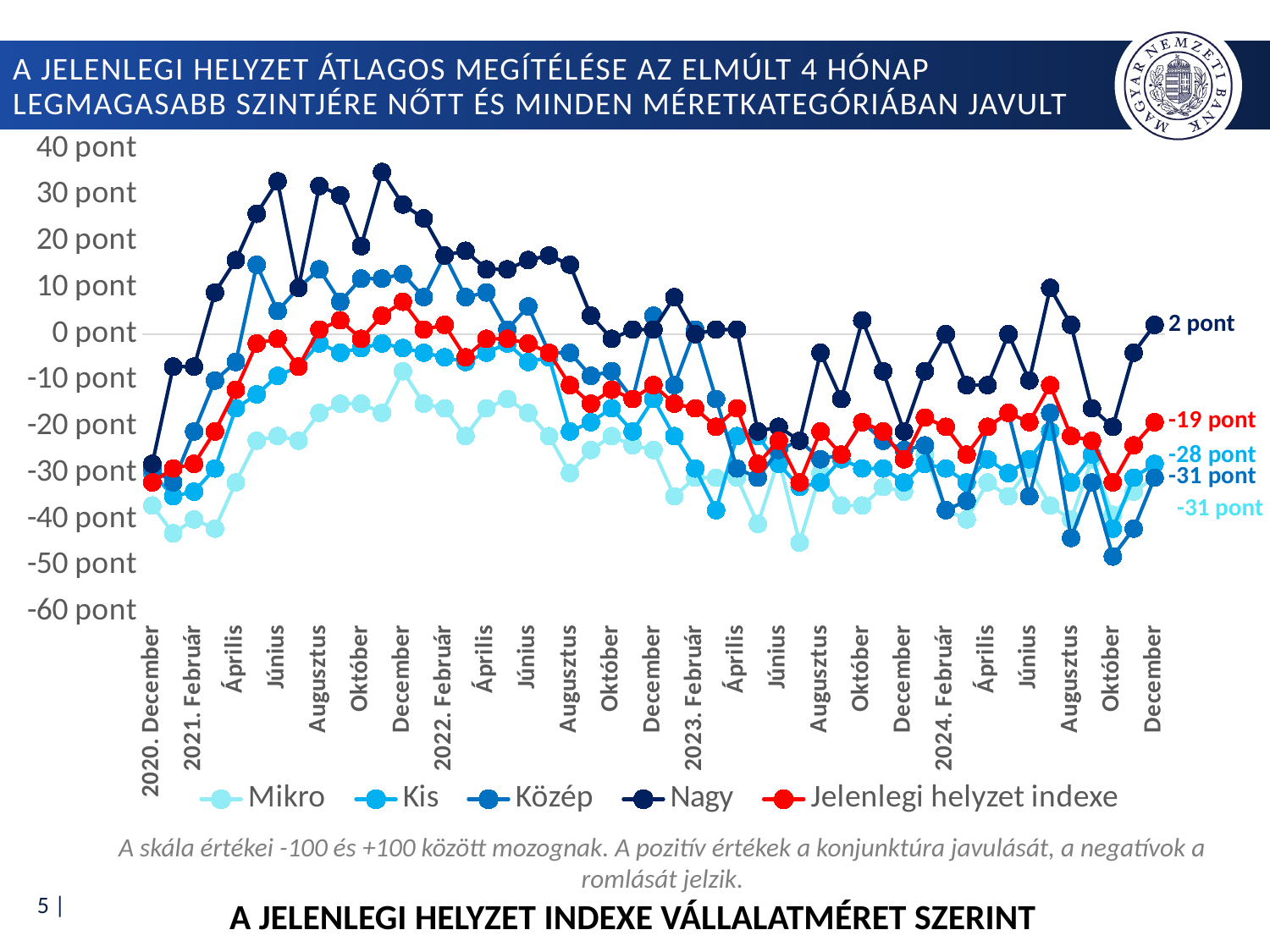
Does the Jelenlegi helyzet indexe series overall rise or fall from 2021 December to 2024 December? fall What kind of chart is shown on the slide? line chart How many series does the legend list? 5 What is the title printed below the chart? A JELENLEGI HELYZET INDEXE VÁLLALATMÉRET SZERINT Is the value of the Nagy series in 2021 Június greater or less than 20 pont? greater What is the value of the Nagy series at the last point (2024 December)? 2 pont Which series has the highest value at the last point (2024 December)? Nagy At the last point (2024 December), which is larger: the Nagy value or the Jelenlegi helyzet indexe value? Nagy Is the value of the Mikro series in 2021 Február greater or less than -30 pont? less What is the value of the Jelenlegi helyzet indexe series at the last point (2024 December)? -19 pont What is the value of the Kis series at the last point (2024 December)? -28 pont What is the difference between the Nagy value and the Jelenlegi helyzet indexe value at the last point (2024 December)? 21 pont